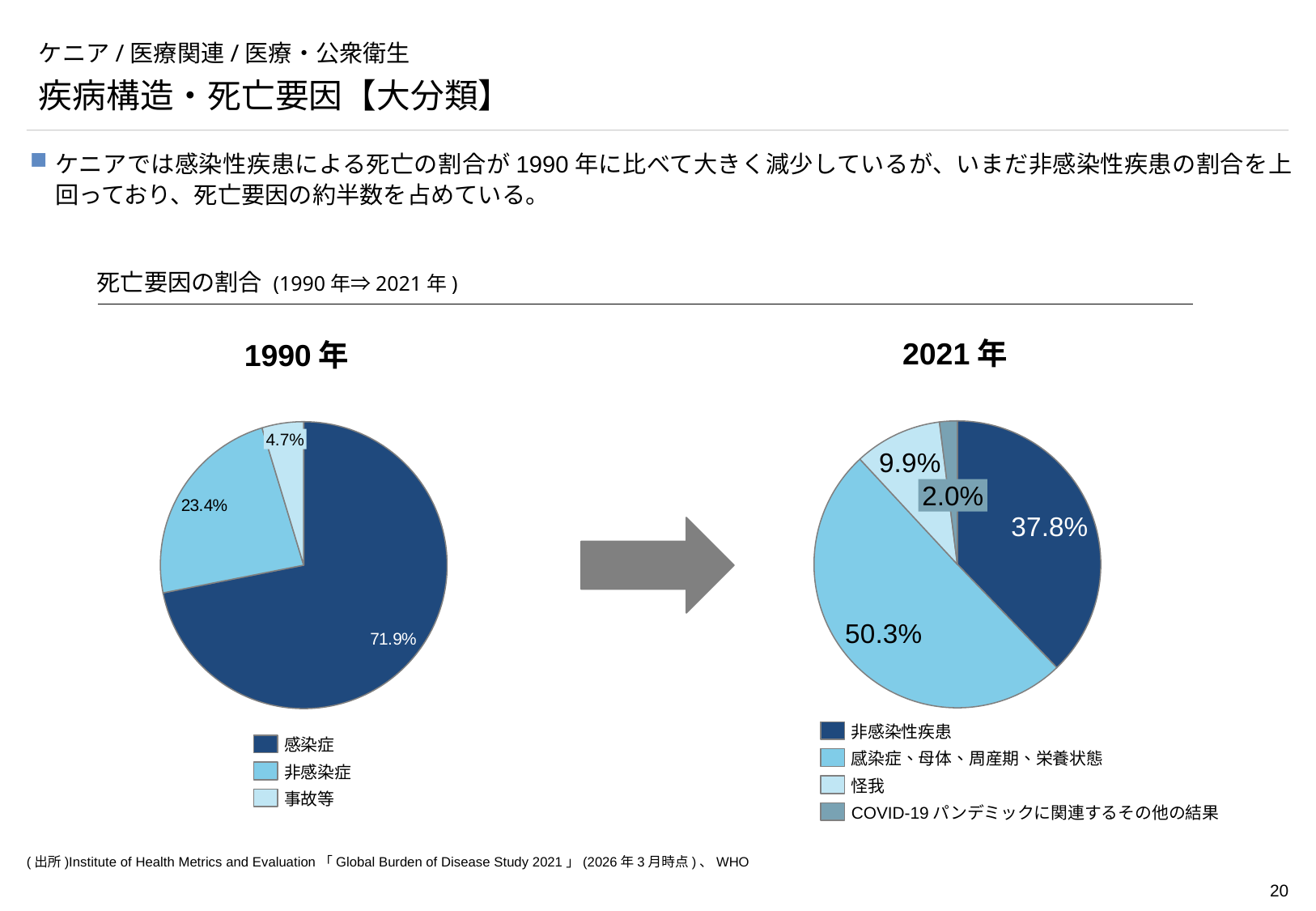
1990年の円グラフで、感染症と非感染症の割合の差は何ポイントですか？ 48.5ポイント 1990年の円グラフで、最も割合が大きい区分はどれですか？ 感染症 2021年の円グラフで、最も割合が小さい区分はどれですか？ COVID-19パンデミックに関連するその他の結果 1990年の円グラフで、感染症の割合は何%ですか？ 71.9% 2021年の円グラフで、感染症、母体、周産期、栄養状態の割合は何%ですか？ 50.3% 2021年の円グラフで、COVID-19パンデミックに関連するその他の結果の割合は何%ですか？ 2.0% 1990年の円グラフの凡例には、いくつの項目がありますか？ 3 2021年の円グラフで、非感染性疾患の割合は何%ですか？ 37.8% 2021年の円グラフには、いくつの区分がありますか？ 4 1990年の円グラフで、事故等の割合は何%ですか？ 4.7% このスライドのグラフはどの種類のグラフですか？ 円グラフ 2021年の円グラフで、非感染性疾患と怪我ではどちらの割合が大きいですか？ 非感染性疾患